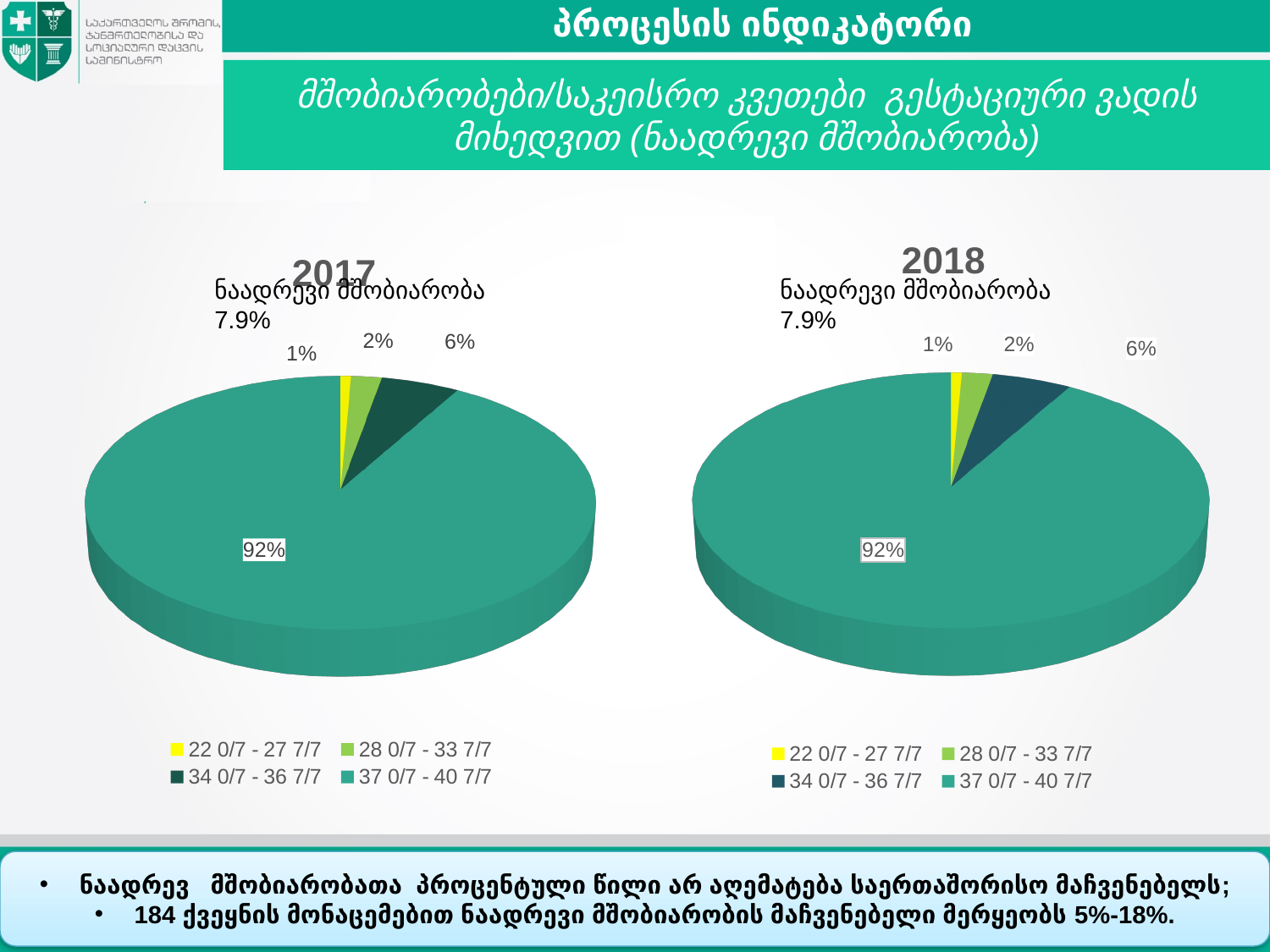
In the 2017 pie chart, what share is shown for the 37 0/7 - 40 7/7 category? 92% In the 2018 pie chart, what share is shown for the 34 0/7 - 36 7/7 category? 6% What year is shown above the pie chart on the right? 2018 How many pie charts are shown on the slide? 2 In the 2017 pie chart, what is the difference between the 34 0/7 - 36 7/7 share and the 28 0/7 - 33 7/7 share? 4% How many categories does the legend of the 2018 pie chart list? 4 In the 2018 pie chart, which is larger: the 34 0/7 - 36 7/7 slice or the 28 0/7 - 33 7/7 slice? 34 0/7 - 36 7/7 In the 2017 pie chart, what share is shown for the 22 0/7 - 27 7/7 category? 1% What kind of chart is used for the 2017 data on the left? pie chart In the 2017 pie chart, which category has the smallest slice? 22 0/7 - 27 7/7 In the 2018 pie chart, which category has the largest slice? 37 0/7 - 40 7/7